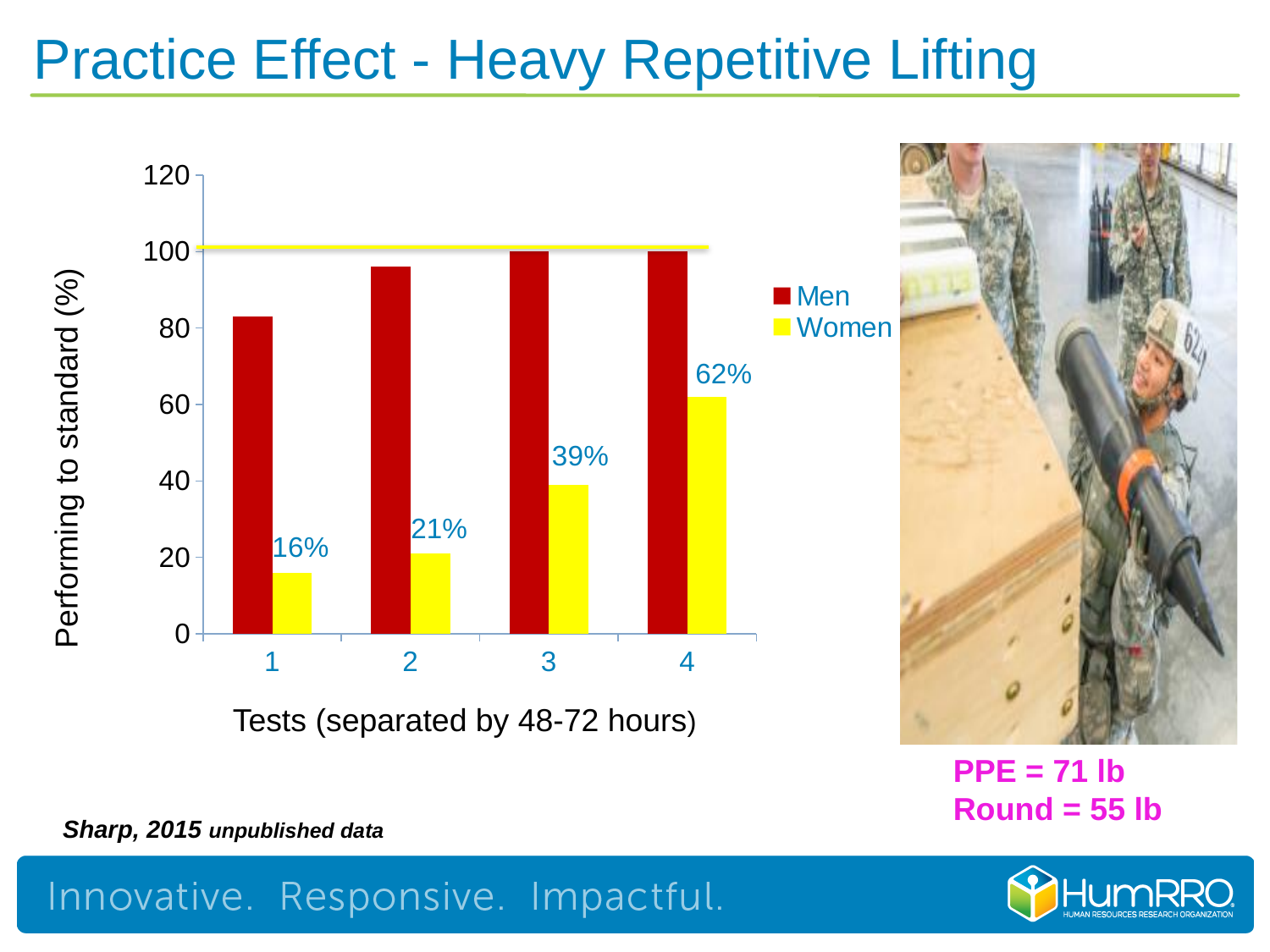
At test 2, which series has the larger value, Men or Women? Men What is the difference between the Women values at test 4 and test 1? 46% How many series does the legend list? 2 What is the value for Women at test 4? 62% At which test is the Women value highest? 4 What is the value for Women at test 1? 16% How many tests are shown on the x axis? 4 Is the value for Men at test 1 greater or less than 80? greater What kind of chart is shown on the slide? bar chart At which test is the Women value lowest? 1 Do the Women values rise or fall from test 1 to test 4? rise What is the value for Women at test 3? 39%